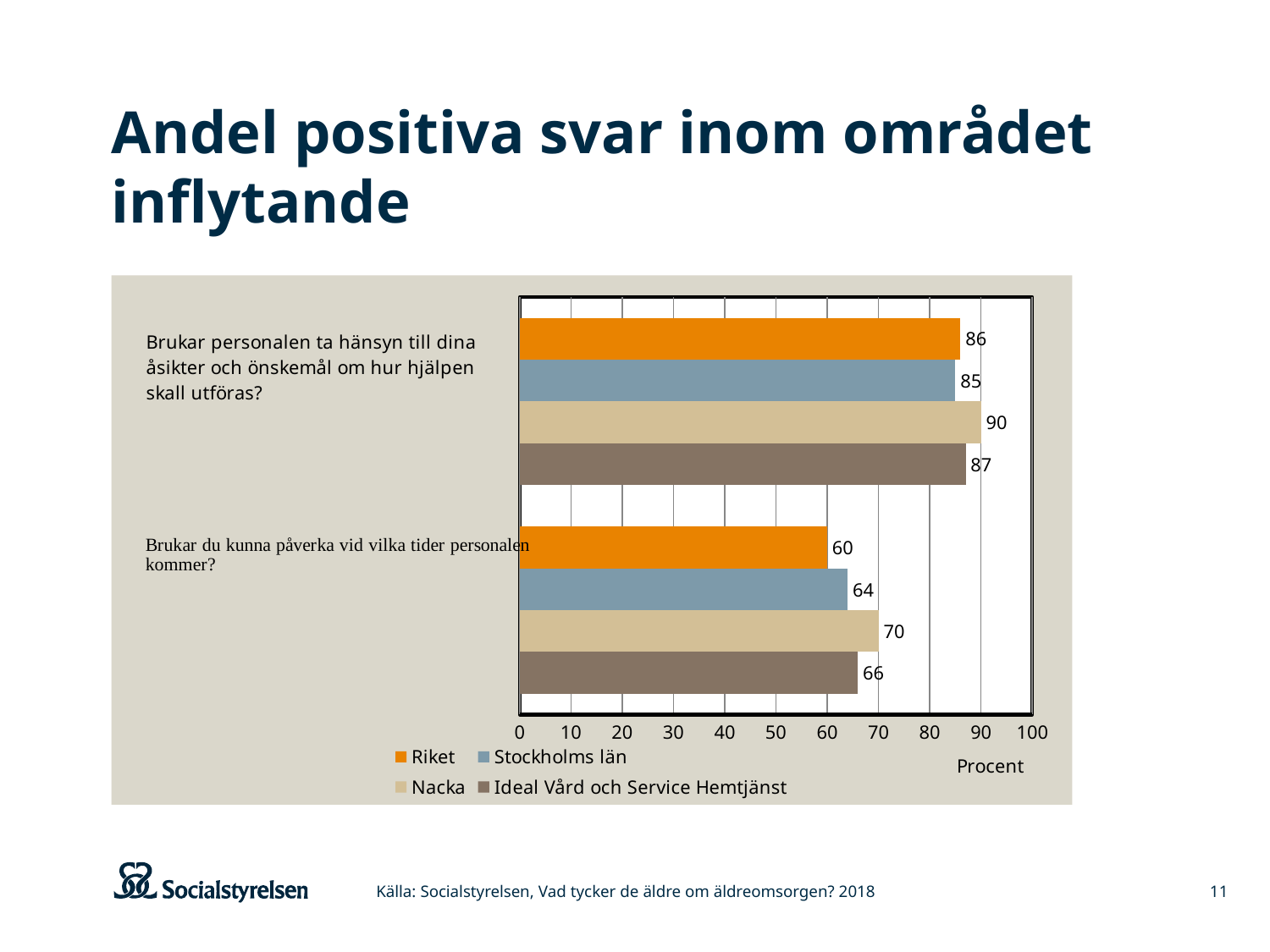
What is the difference between the Nacka value and the Riket value on the question 'Brukar du kunna påverka vid vilka tider personalen kommer?' 10 What is the value for Ideal Vård och Service Hemtjänst on the question 'Brukar personalen ta hänsyn till dina åsikter och önskemål om hur hjälpen skall utföras?' 87 How many questions (categories) are shown on the chart? 2 What is the value for Stockholms län on the question 'Brukar du kunna påverka vid vilka tider personalen kommer?' 64 What kind of chart is shown on the slide? Bar chart Which series has the highest value on the question 'Brukar du kunna påverka vid vilka tider personalen kommer?' Nacka What is the label of the horizontal axis? Procent What is the value for Nacka on the question 'Brukar personalen ta hänsyn till dina åsikter och önskemål om hur hjälpen skall utföras?' 90 Which series has the lowest value on the question 'Brukar personalen ta hänsyn till dina åsikter och önskemål om hur hjälpen skall utföras?' Stockholms län Which is larger on the question 'Brukar personalen ta hänsyn till dina åsikter och önskemål om hur hjälpen skall utföras?': Riket or Nacka? Nacka How many series does the legend list? 4 What is the value for Riket on the question 'Brukar du kunna påverka vid vilka tider personalen kommer?' 60